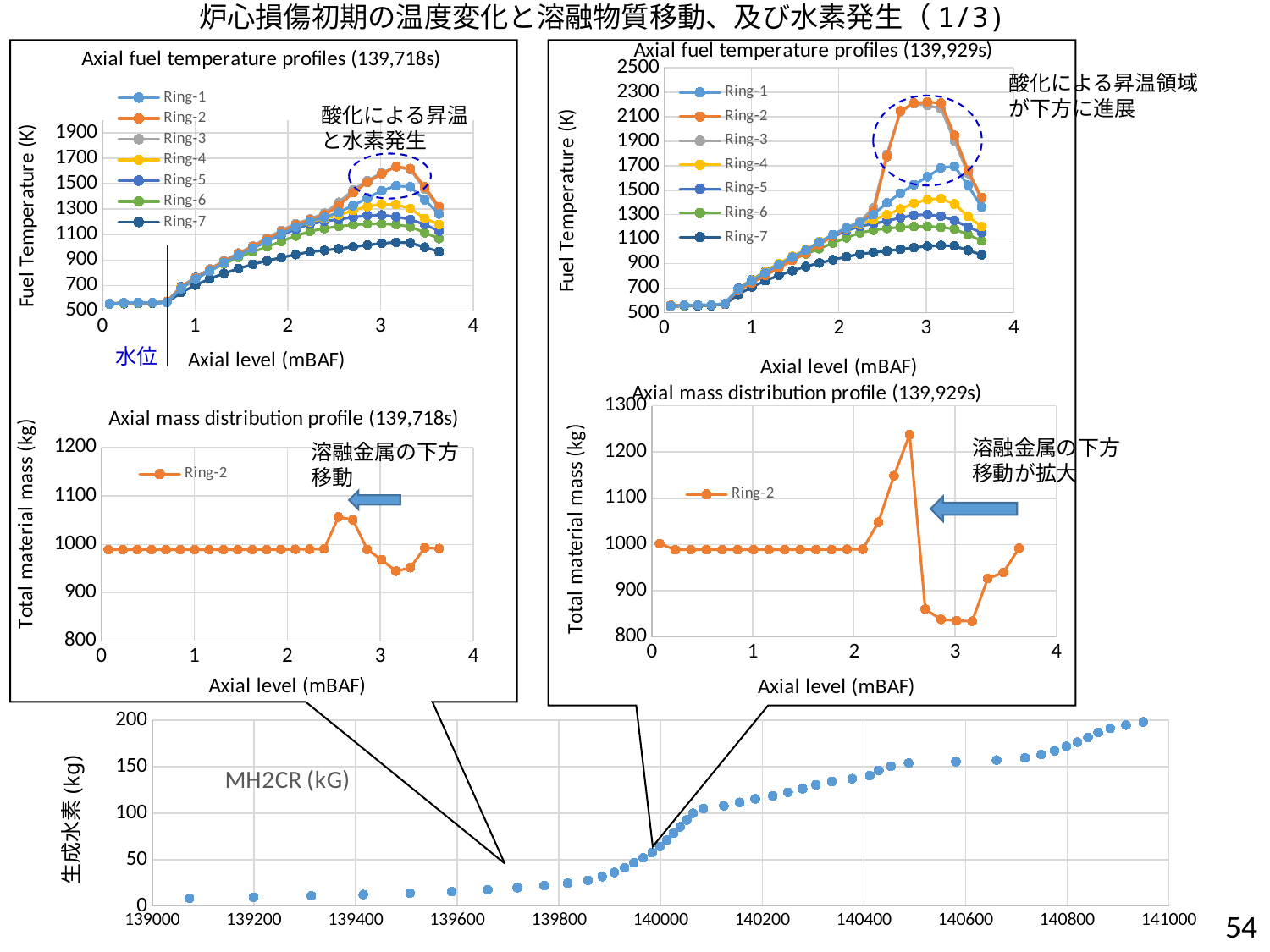
Which ring is the only series shown in the chart titled "Axial mass distribution profile (139,718s)"? Ring-2 In the chart titled "Axial fuel temperature profiles (139,929s)", is the peak value of Ring-2 greater or less than 1900? greater In the bottom chart labelled "MH2CR (kG)", do the values rise or fall as the x axis increases? rise In the chart titled "Axial mass distribution profile (139,718s)", is the peak value of Ring-2 greater or less than 1100? less What kind of chart is the bottom chart labelled "MH2CR (kG)"? scatter chart In the chart titled "Axial mass distribution profile (139,929s)", is the peak value of Ring-2 greater or less than 1100? greater In the chart titled "Axial fuel temperature profiles (139,929s)", which ring has the lowest temperature at axial level 3? Ring-7 In the chart titled "Axial mass distribution profile (139,929s)", how many series does the legend list? 1 In the chart titled "Axial fuel temperature profiles (139,718s)", how many series does the legend list? 7 What kind of chart is the chart titled "Axial fuel temperature profiles (139,929s)"? line chart